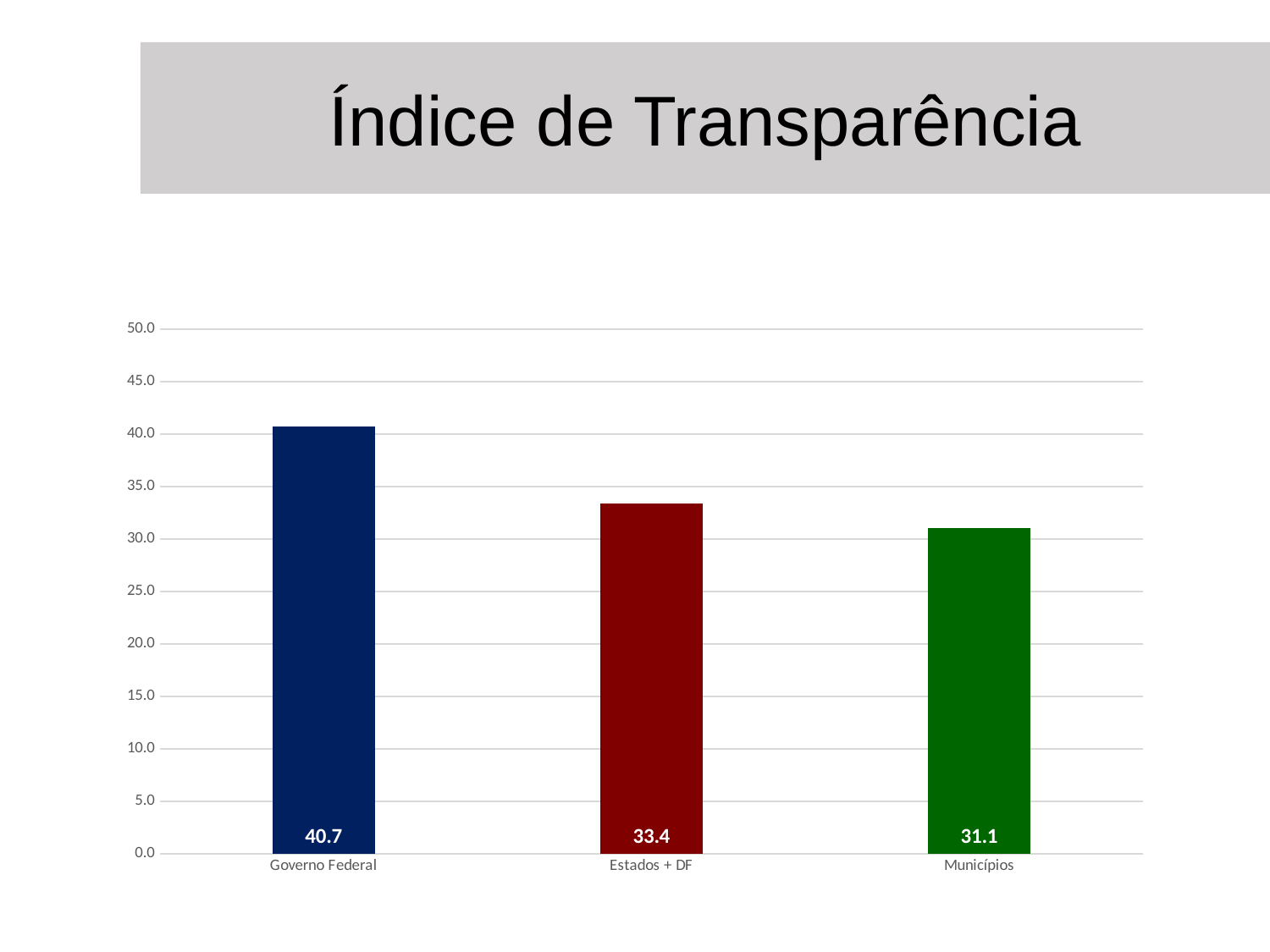
What is the value for Estados + DF? 33.4 Which category has the lowest value? Municípios What is the value for Municípios? 31.1 Which is larger, the value for Governo Federal or the value for Estados + DF? Governo Federal What is the difference between the values for Governo Federal and Municípios? 9.6 What is the difference between the values for Estados + DF and Municípios? 2.3 Is the value for Governo Federal greater or less than 40.0? greater What is the value for Governo Federal? 40.7 What kind of chart is shown on the slide? bar chart Which category has the highest value? Governo Federal What is the title of the slide? Índice de Transparência How many categories are shown in the chart? 3